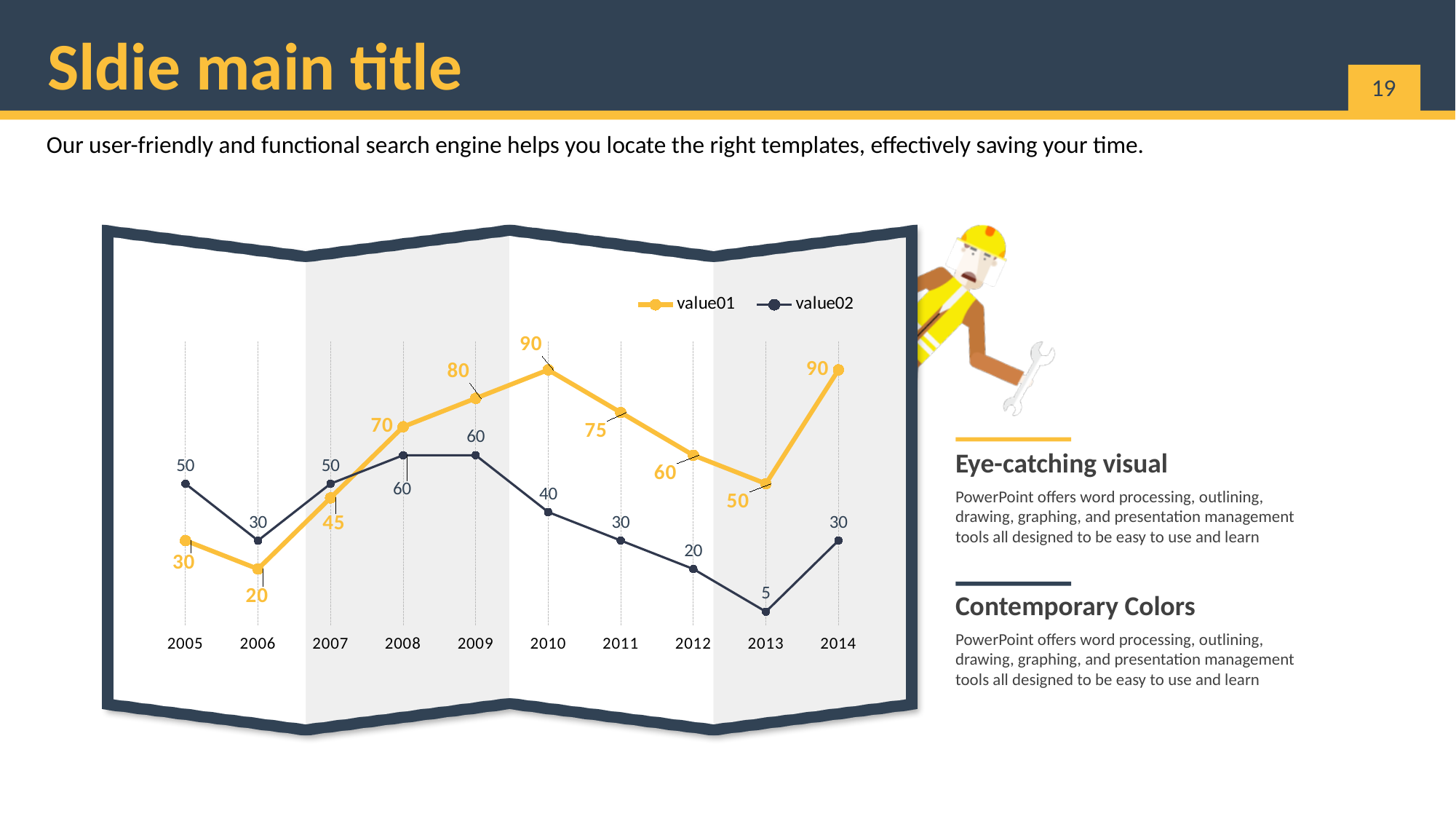
In which year is value01 lowest? 2006 How many years are shown on the x axis? 10 What is the difference between value01 and value02 in 2013? 45 Which series has the larger value in 2005, value01 or value02? value02 Does value02 rise or fall from 2009 to 2013? fall What is the value of value02 in 2013? 5 What kind of chart is shown on the slide? line chart In which year is value02 lowest? 2013 How many series does the legend list? 2 What is the value of value01 in 2006? 20 What is the value of value01 in 2010? 90 What is the value of value02 in 2008? 60